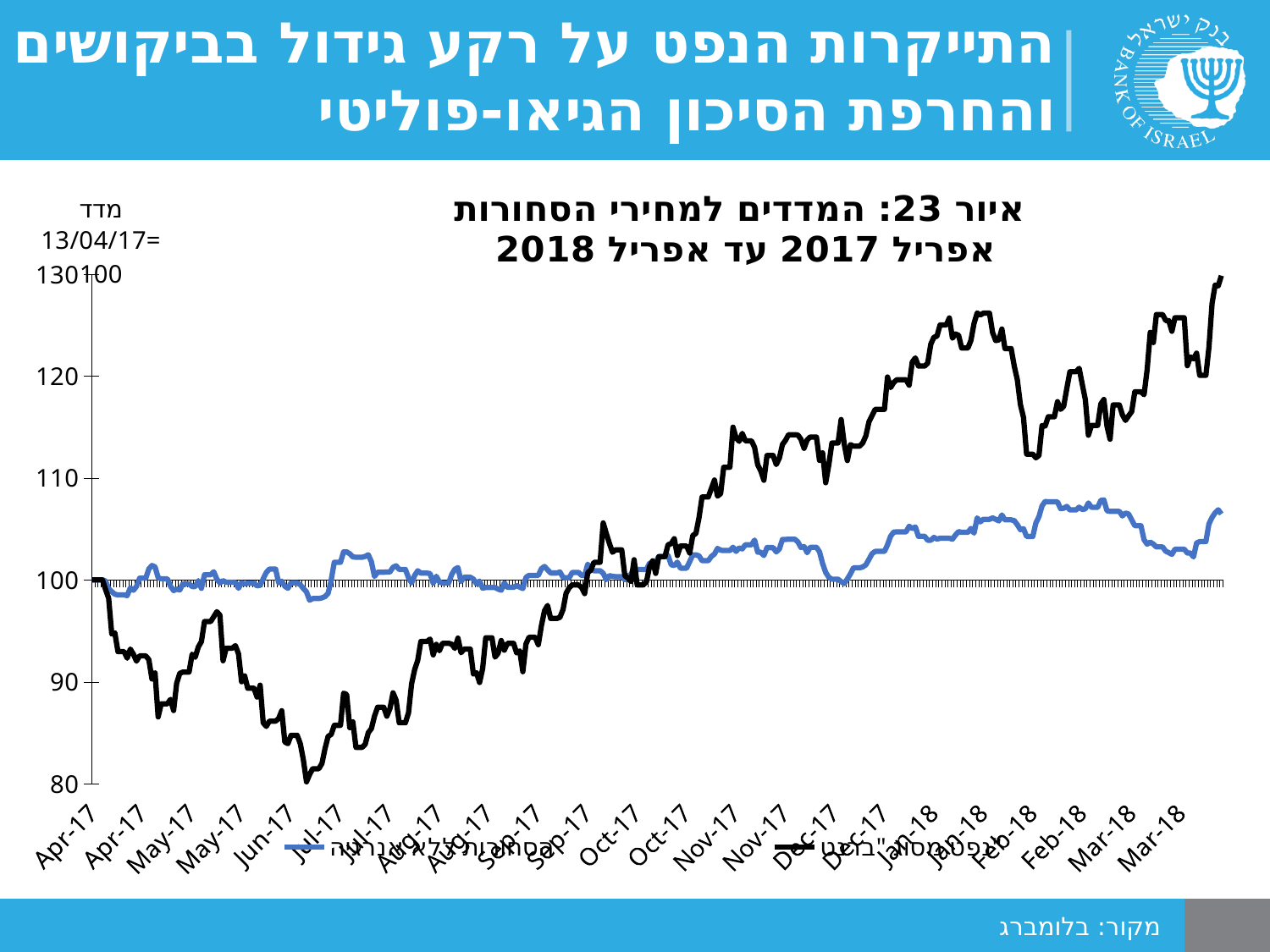
Is the value of the blue line at the end of the series (Mar-18) greater or less than 110? less Is the value of the black line at the end of the series (Mar-18) greater or less than 120? greater Is the lowest point of the black line, around Jun-17, greater or less than 90? less What is the title of the chart? איור 23: המדדים למחירי הסחורות אפריל 2017 עד אפריל 2018 Which line is higher at the end of the series (Mar-18), the black line or the blue line? the black line What is the highest value shown on the vertical axis? 130 Does the black line rise or fall overall from Apr-17 to Mar-18? rise At what value do both lines start at Apr-17? 100 How many series does the legend list? 2 Which line is higher around Jun-17, the black line or the blue line? the blue line What kind of chart is shown on the slide? line chart